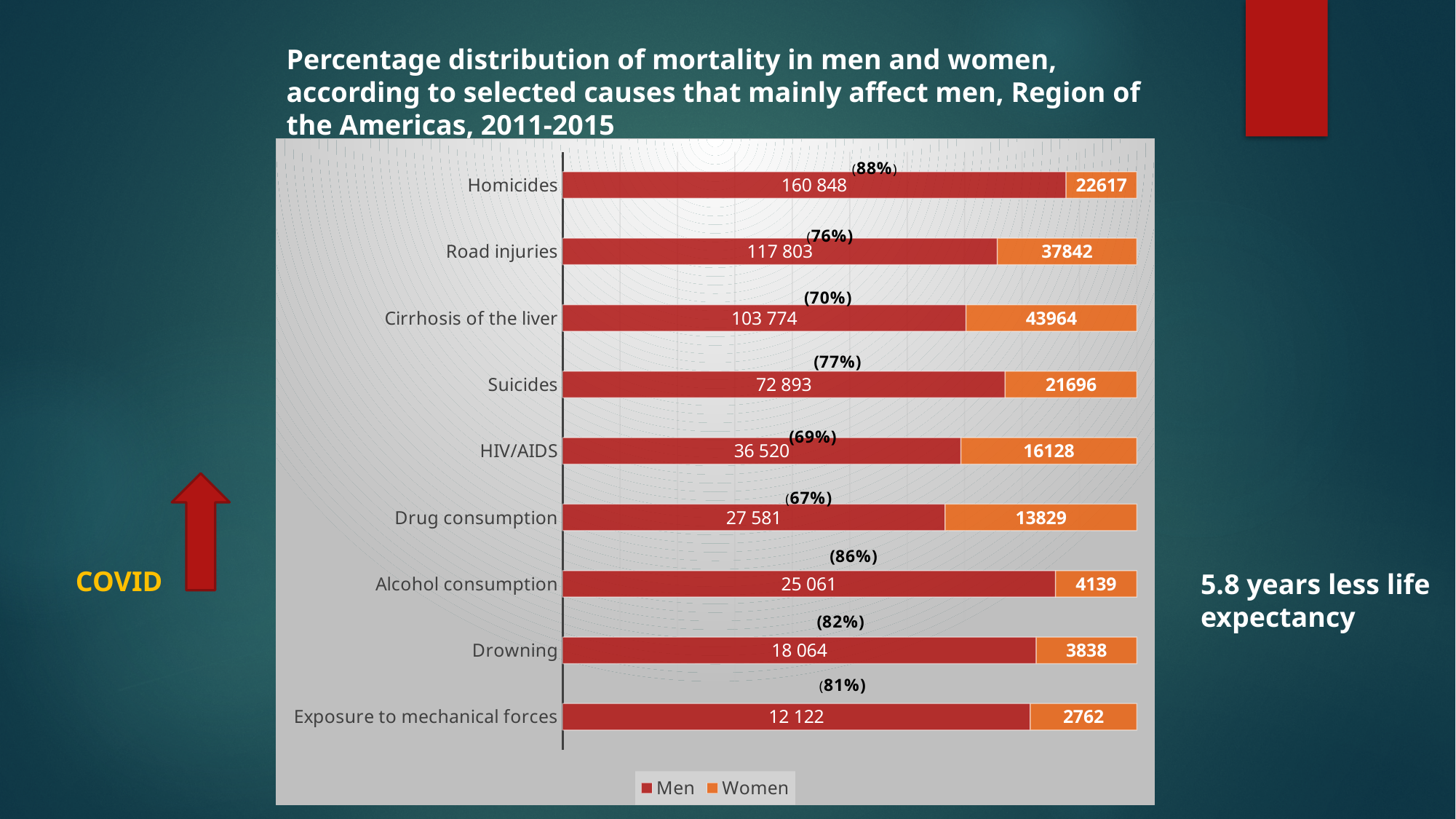
What is the value for Women in the Cirrhosis of the liver category? 43964 Which category has the highest value for Women? Cirrhosis of the liver Which category has the lowest value for Women? Exposure to mechanical forces Which is larger: the Women value for Road injuries or the Women value for Suicides? Road injuries Which category has the highest value for Men? Homicides How many series does the legend list? 2 What are the two entries in the chart legend? Men and Women What is the value for Men in the Homicides category? 160 848 What kind of chart is shown on the slide? Bar chart How many categories (causes) are shown in the chart? 9 What is the difference between the Women value for Road injuries and the Women value for Homicides? 15225 What percentage is shown in parentheses above the Alcohol consumption bar? 86%